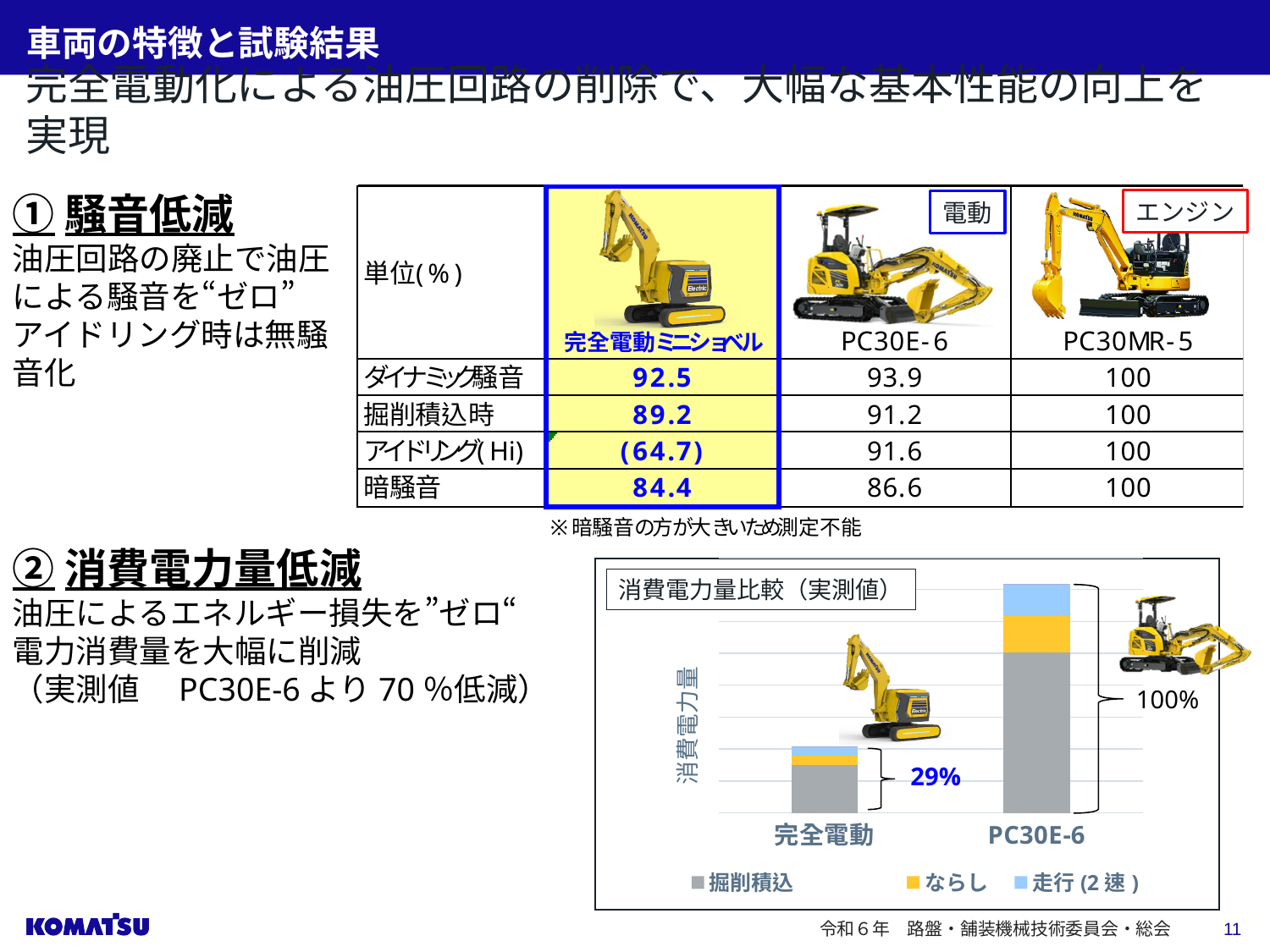
In the 消費電力量比較（実測値） chart, which bar is the lowest? 完全電動 In the 消費電力量比較（実測値） chart, what is the total labelled for the PC30E-6 bar? 100% What kind of chart is shown in the 消費電力量比較（実測値） chart? stacked bar chart In the 消費電力量比較（実測値） chart, which bar is the highest? PC30E-6 In the 消費電力量比較（実測値） chart, which series is the largest segment of the PC30E-6 bar? 掘削積込 In the 消費電力量比較（実測値） chart, what is the total labelled for the 完全電動 bar? 29% What is the y-axis label of the 消費電力量比較（実測値） chart? 消費電力量 What are the three legend entries of the 消費電力量比較（実測値） chart? 掘削積込, ならし, 走行(2速) In the 消費電力量比較（実測値） chart, which bar is larger, 完全電動 or PC30E-6? PC30E-6 How many bars (categories) are plotted in the 消費電力量比較（実測値） chart? 2 How many series does the legend of the 消費電力量比較（実測値） chart list? 3 In the 消費電力量比較（実測値） chart, what is the difference between the PC30E-6 total and the 完全電動 total? 71%